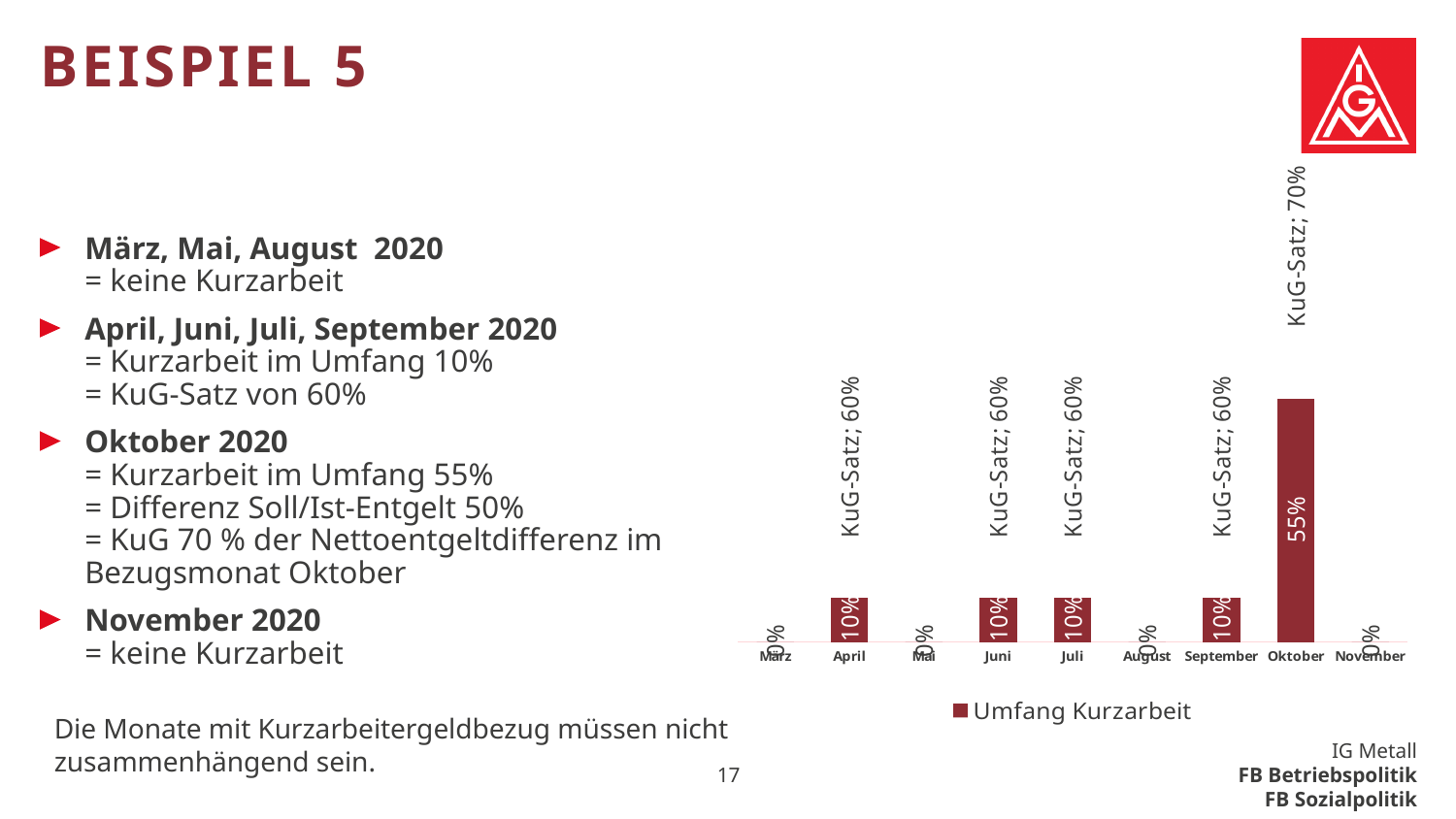
What KuG-Satz is labelled above the Oktober bar? KuG-Satz; 70% What is the value for April in the chart? 10% What is the legend entry of the chart? Umfang Kurzarbeit What is the value for Oktober in the chart? 55% What is the value for August in the chart? 0% What kind of chart is shown on the slide? Bar chart Which month has the highest value in the chart? Oktober What is the difference between the values for Oktober and September? 45% How many series does the chart legend list? 1 What is the value for November in the chart? 0% Which is larger, the value for Juni or the value for Mai? Juni How many months are shown on the x axis of the chart? 9